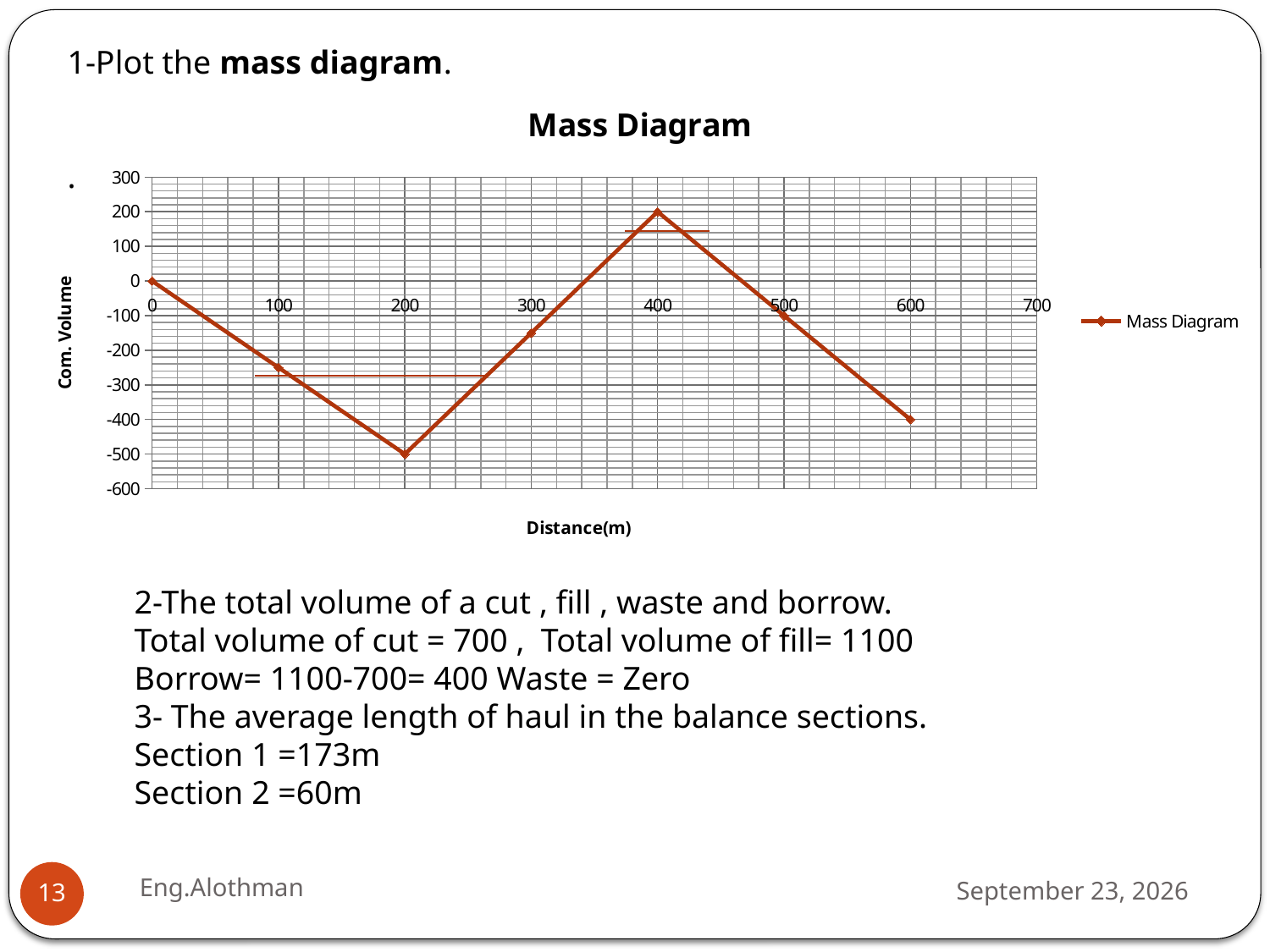
What is the Com. Volume value at a distance of 200 m? -500 How many data points are plotted on the Mass Diagram line? 7 What is the Com. Volume value at a distance of 400 m? 200 How many series does the legend list? 1 What type of chart is shown on the slide? line chart What is the title of the chart? Mass Diagram At which distance does the Mass Diagram reach its lowest value? 200 At which distance does the Mass Diagram reach its highest value? 400 What is the Com. Volume value at a distance of 500 m? -100 What is the Com. Volume value at a distance of 600 m? -400 Is the value at a distance of 100 m greater or less than -200? less Does the Mass Diagram line rise or fall between distances 200 m and 400 m? rise